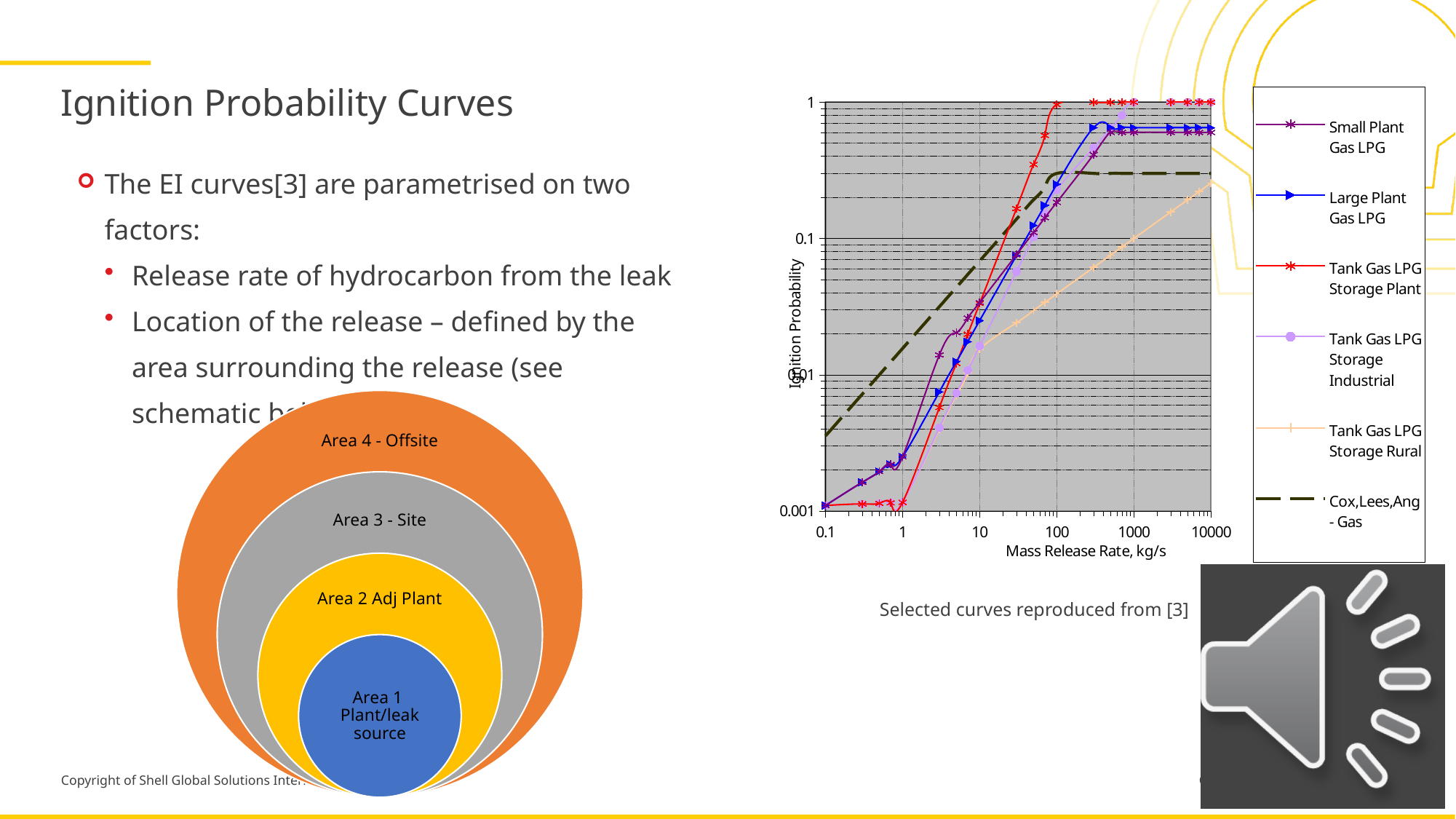
At 10000 kg/s, which series has the higher ignition probability: Tank Gas LPG Storage Plant or Tank Gas LPG Storage Rural? Tank Gas LPG Storage Plant Is the ignition probability for Large Plant Gas LPG at 10000 kg/s greater or less than 0.1? greater Is the ignition probability for Tank Gas LPG Storage Rural at 10000 kg/s greater or less than 0.1? greater Which series is drawn as a dashed line in the chart? Cox,Lees,Ang - Gas Is the ignition probability for Cox,Lees,Ang - Gas at 0.1 kg/s greater or less than 0.01? less How many series does the chart legend list? 6 What kind of chart is shown on the slide? line chart What is the x-axis title of the chart? Mass Release Rate, kg/s Do the ignition probability curves generally rise or fall as mass release rate increases? rise Which series has the highest ignition probability at a mass release rate of 1 kg/s? Cox,Lees,Ang - Gas